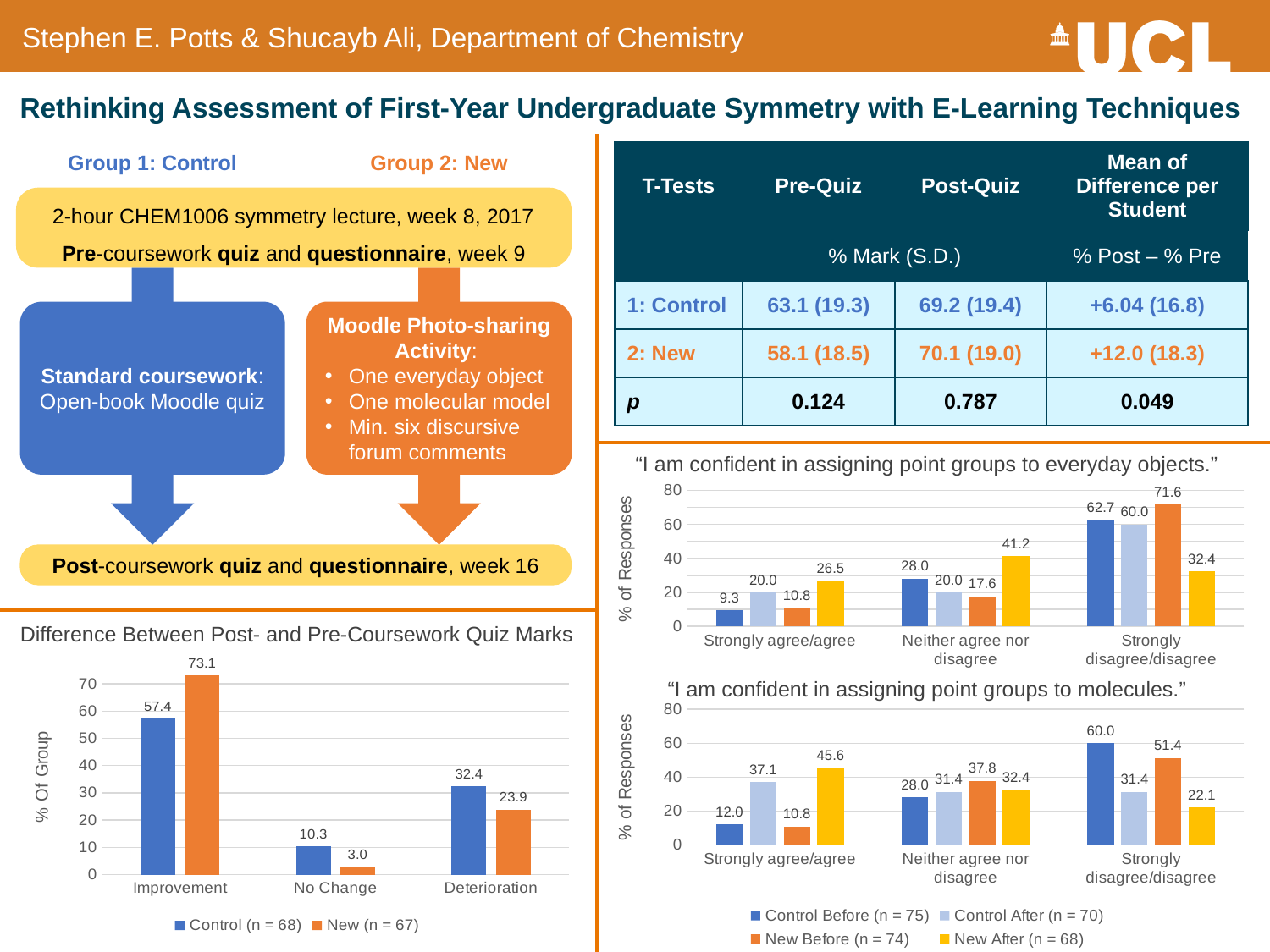
In the chart 'I am confident in assigning point groups to everyday objects.', what is the difference between New Before and New After in the Strongly disagree/disagree category? 39.2 In the chart 'I am confident in assigning point groups to molecules.', which is larger in the Neither agree nor disagree category: New Before or New After? New Before In the chart 'Difference Between Post- and Pre-Coursework Quiz Marks', what is the value for New in the Improvement category? 73.1 In the chart 'Difference Between Post- and Pre-Coursework Quiz Marks', which category has the lowest value for New? No Change What kind of chart is 'Difference Between Post- and Pre-Coursework Quiz Marks'? Bar chart In the chart 'I am confident in assigning point groups to everyday objects.', what is the value for New After in the Strongly agree/agree category? 26.5 In the chart 'I am confident in assigning point groups to everyday objects.', which series has the highest value in the Strongly disagree/disagree category? New Before (n = 74) How many categories are shown on the x axis of the chart 'I am confident in assigning point groups to molecules.'? 3 In the chart 'Difference Between Post- and Pre-Coursework Quiz Marks', what is the difference between the Control and New values for No Change? 7.3 In the chart 'Difference Between Post- and Pre-Coursework Quiz Marks', what is the value for Control in the Deterioration category? 32.4 In the chart 'I am confident in assigning point groups to molecules.', what is the value for Control After in the Strongly agree/agree category? 37.1 In the chart 'Difference Between Post- and Pre-Coursework Quiz Marks', how many series does the legend list? 2